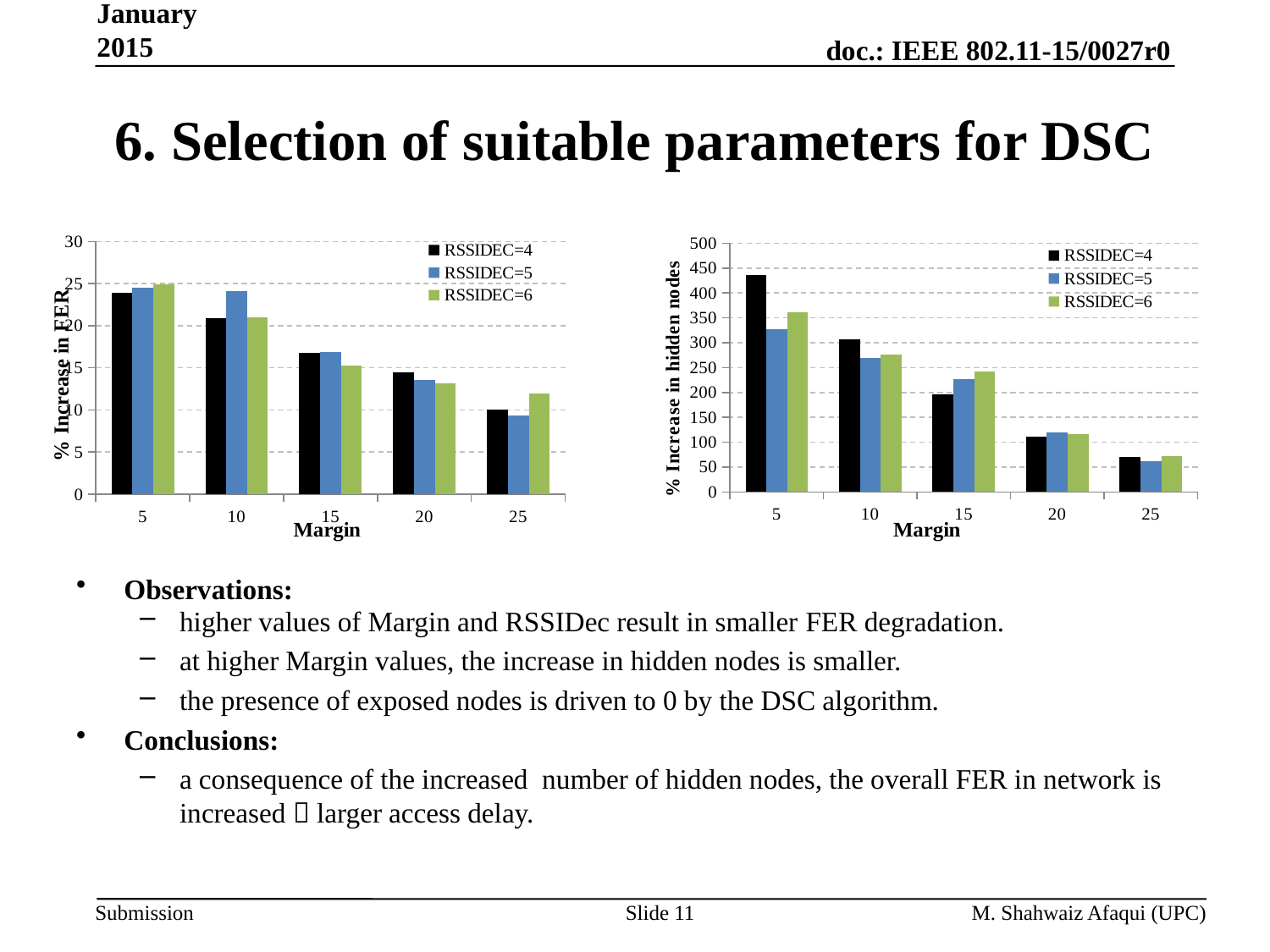
How many Margin categories are shown on the x axis of the left chart (% Increase in FER)? 5 In the right chart (% Increase in hidden nodes), do the RSSIDEC=4 values rise or fall as Margin increases from 5 to 25? fall What kind of chart is the left chart (% Increase in FER)? bar chart In the left chart (% Increase in FER), is the value for RSSIDEC=4 at Margin 25 greater or less than 15? less In the right chart (% Increase in hidden nodes), is the value for RSSIDEC=5 at Margin 25 greater or less than 100? less How many series does the legend of the right chart (% Increase in hidden nodes) list? 3 In the right chart (% Increase in hidden nodes), is the value for RSSIDEC=4 at Margin 5 greater or less than 400? greater In the right chart (% Increase in hidden nodes), which is larger at Margin 5: RSSIDEC=4 or RSSIDEC=5? RSSIDEC=4 In the left chart (% Increase in FER), which Margin value has the lowest bar for RSSIDEC=5? 25 In the right chart (% Increase in hidden nodes), which Margin value has the highest bar for RSSIDEC=4? 5 What is the x-axis label of the right chart (% Increase in hidden nodes)? Margin